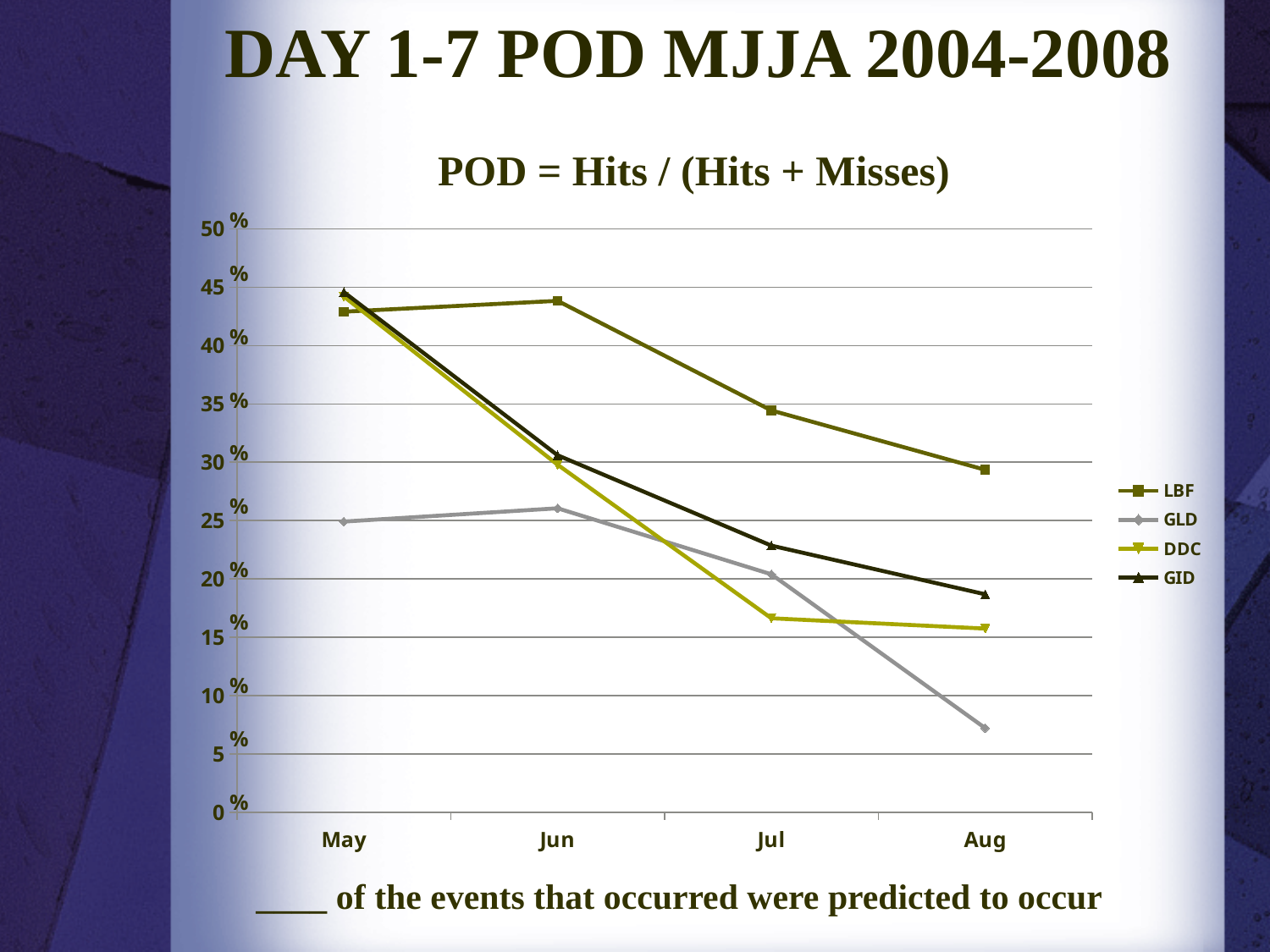
Is the value for GLD in Aug greater or less than 10%? less What kind of chart is shown on the slide? line chart Which series has the lowest value in Jul? DDC Is the value for LBF in Jul greater or less than 30%? greater How many months are shown along the x axis? 4 Is the value for DDC in Aug greater or less than 20%? less Which is larger in Jul, the value for GID or the value for DDC? GID Does the GLD series rise or fall from Jun to Aug? fall Which series has the highest value in Aug? LBF How many series does the legend list? 4 What is the title of the slide containing the chart? DAY 1-7 POD MJJA 2004-2008 Which series has the lowest value in Aug? GLD